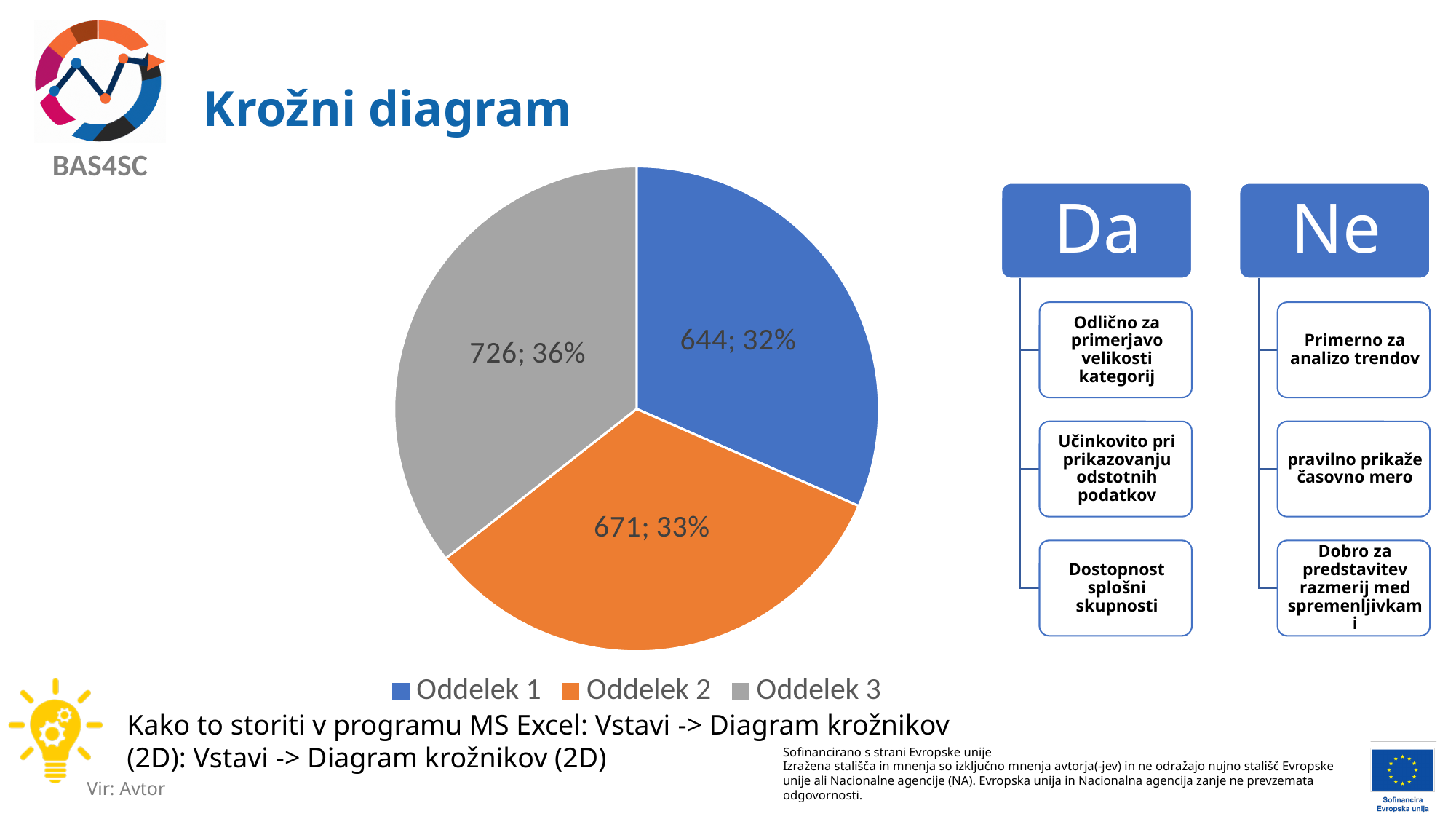
What is the value for Oddelek 3? 726 Which category has the smallest slice? Oddelek 1 What share of the pie does Oddelek 1 represent? 32% What is the difference between the values for Oddelek 3 and Oddelek 1? 82 What colour is the slice for Oddelek 2? orange Which is larger, the value for Oddelek 2 or Oddelek 1? Oddelek 2 What kind of chart is shown on the slide? pie chart What is the value for Oddelek 2? 671 How many slices does the pie chart have? 3 Which category has the largest slice? Oddelek 3 What is the value for Oddelek 1? 644 What share of the pie does Oddelek 3 represent? 36%